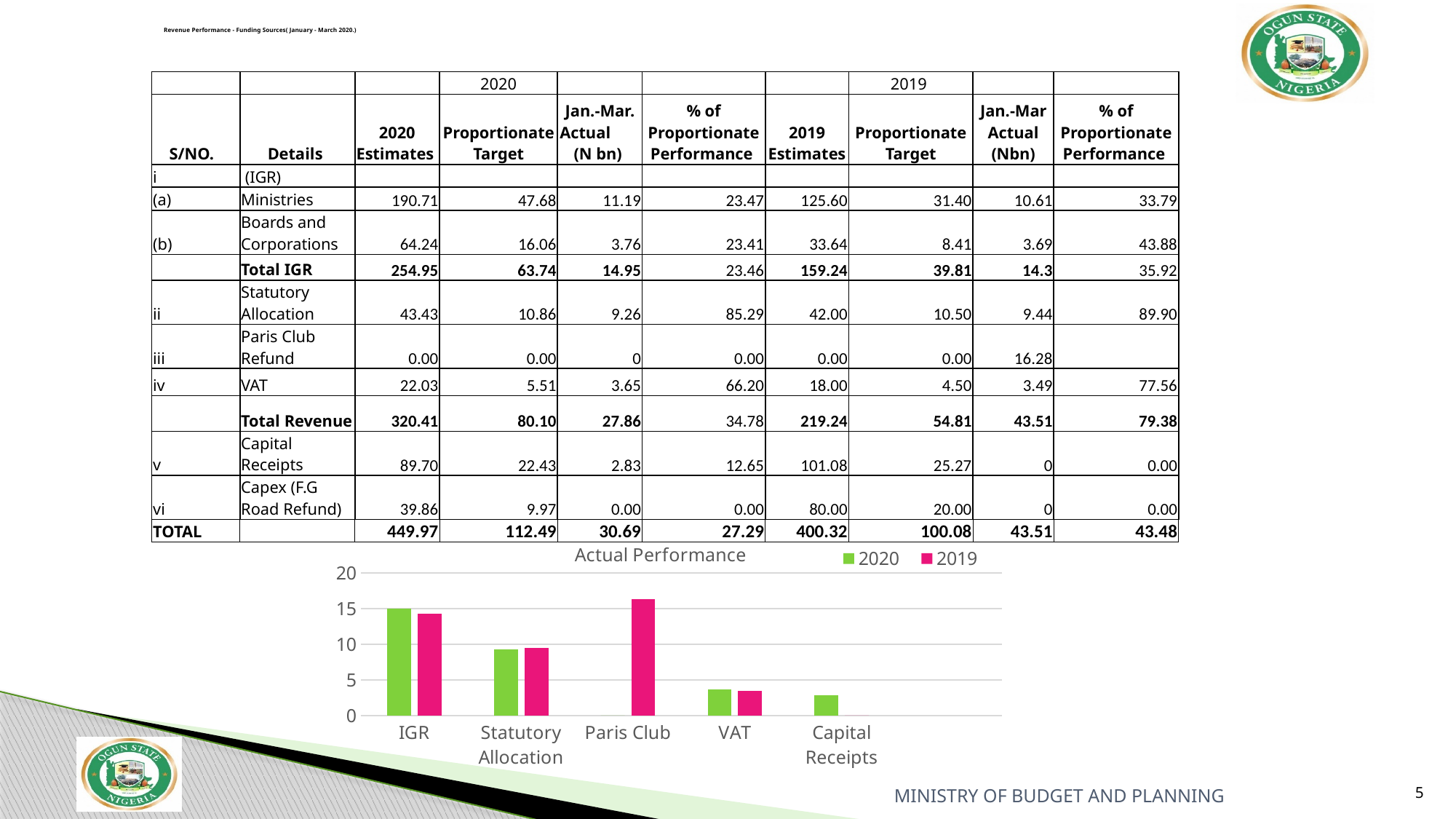
How many series does the legend of the Actual Performance chart list? 2 Which category has the highest 2020 bar in the Actual Performance chart? IGR In the Actual Performance chart, which is larger for 2020: IGR or Statutory Allocation? IGR Which category has the highest 2019 bar in the Actual Performance chart? Paris Club In the Actual Performance chart, is the 2020 value for IGR greater or less than 10? greater Which colour represents the 2020 series in the Actual Performance chart? green What kind of chart is shown below the table on the slide? bar chart In the Actual Performance chart, is the 2020 value for Capital Receipts greater or less than 5? less In the Actual Performance chart, is the 2020 value for VAT greater or less than 5? less What is the title of the chart on the slide? Actual Performance How many categories are shown on the x axis of the Actual Performance chart? 5